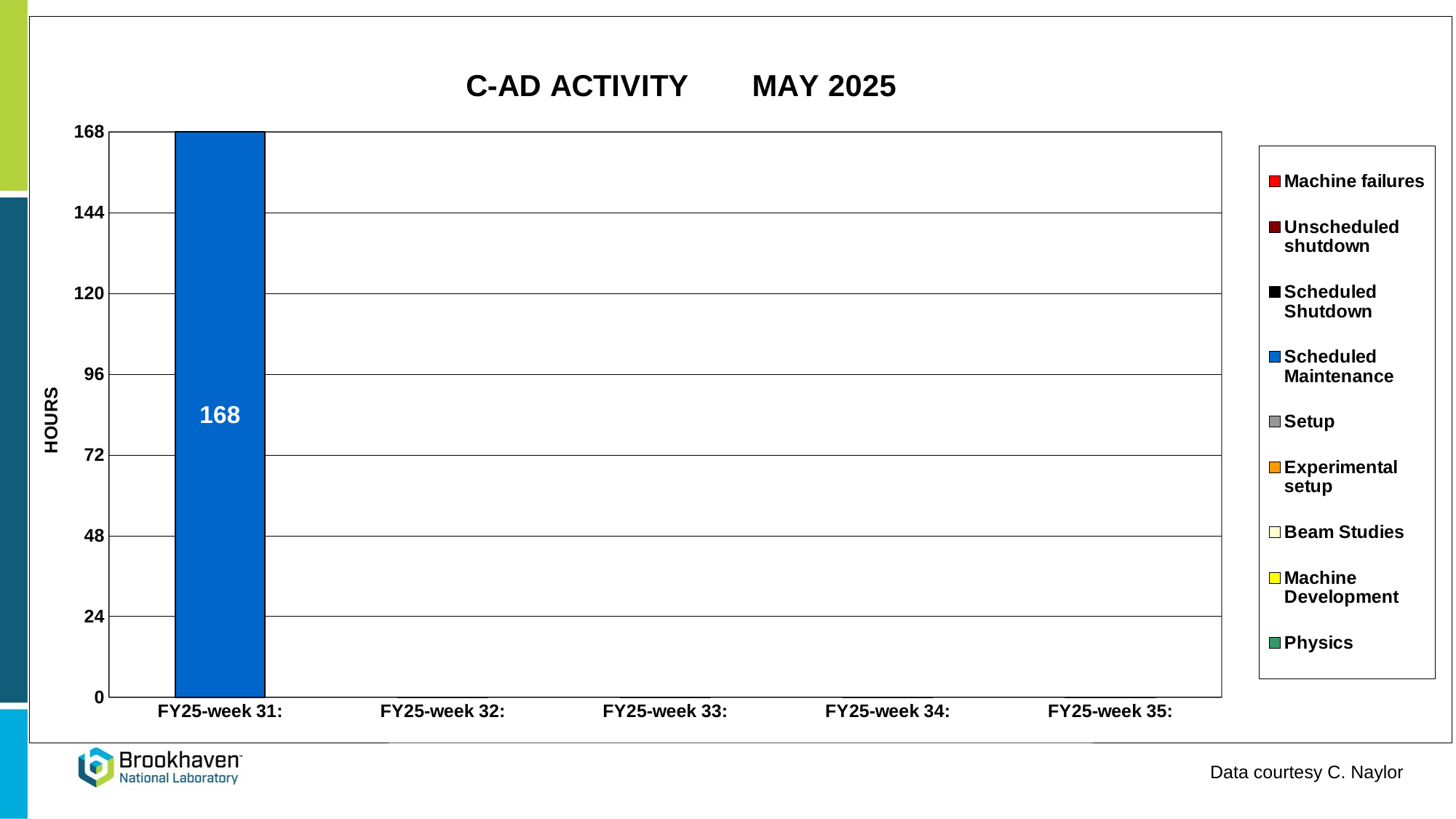
Which category has the highest value? FY25-week 31: How many categories are shown on the x axis? 5 Is the value for FY25-week 31 greater or less than 144? greater What is the maximum value shown on the y axis? 168 How many categories have a visible bar plotted? 1 Which category is listed last on the x axis? FY25-week 35: Which series does the bar for FY25-week 31 belong to, according to the legend colour? Scheduled Maintenance How many series does the legend list? 9 What is the value of the bar for FY25-week 31? 168 What is the label of the y axis? HOURS What kind of chart is shown on the slide? bar chart What is the title of the chart? C-AD ACTIVITY MAY 2025